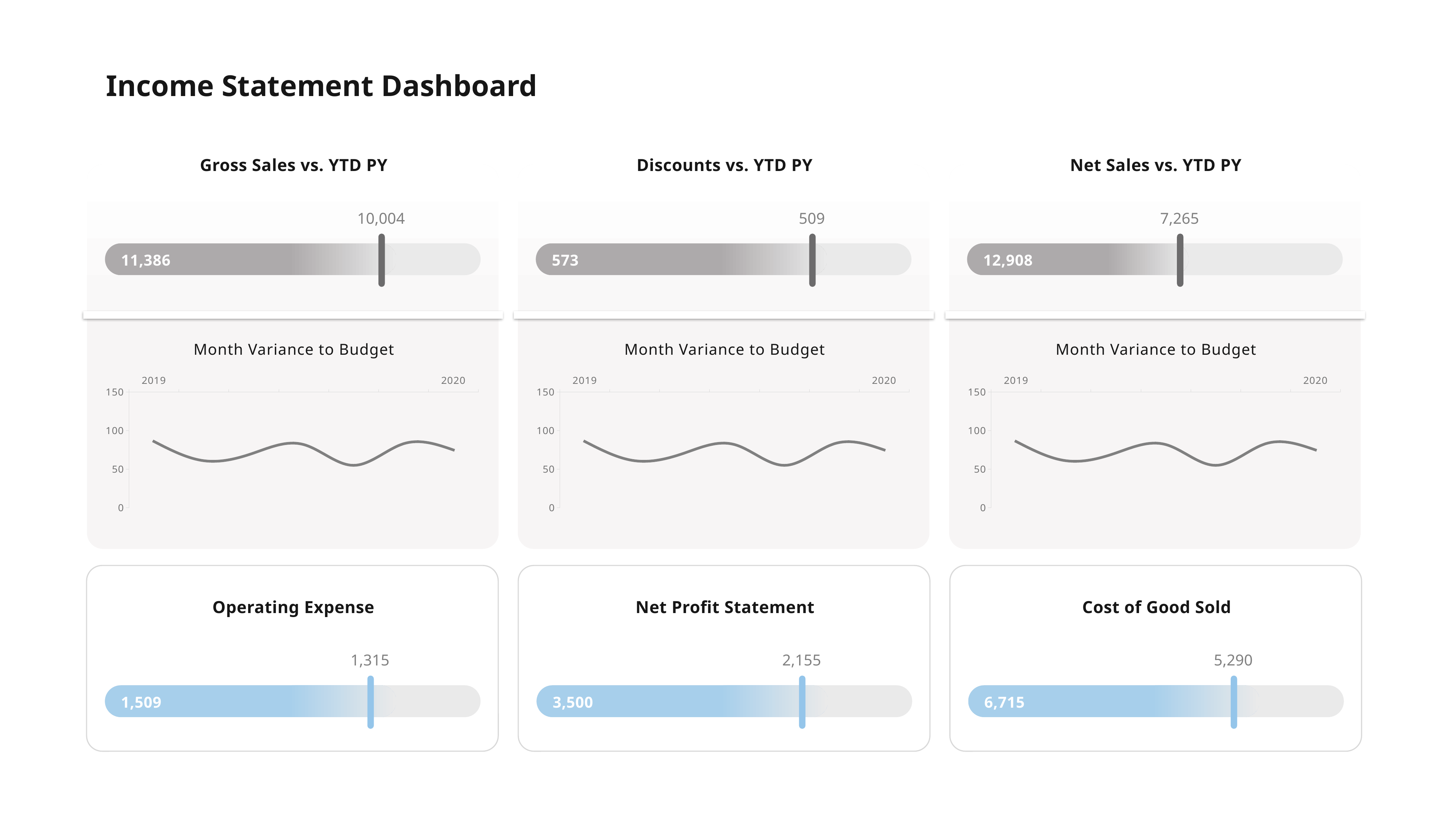
In the Month Variance to Budget chart under Net Sales vs. YTD PY, is the highest point of the line greater or less than 100? less What years are labelled on the x axis of the Month Variance to Budget chart under Discounts vs. YTD PY? 2019 and 2020 In the Discounts vs. YTD PY chart, what is the difference between the bar value and the target marker value? 64 In the Operating Expense chart, what is the value shown on the bar? 1,509 In the Net Sales vs. YTD PY chart, what is the difference between the bar value and the target marker value? 5,643 In the Gross Sales vs. YTD PY chart, what is the value shown on the bar? 11,386 In the Discounts vs. YTD PY chart, what is the value shown on the bar? 573 In the Net Profit Statement chart, which is larger, the bar value or the target marker value? the bar value (3,500) In the Net Sales vs. YTD PY chart, what is the target marker value printed above the bar? 7,265 In the Gross Sales vs. YTD PY chart, what is the target marker value printed above the bar? 10,004 What kind of chart is the Month Variance to Budget chart under Gross Sales vs. YTD PY? line chart In the Cost of Good Sold chart, what is the difference between the bar value 6,715 and the marker value 5,290? 1,425